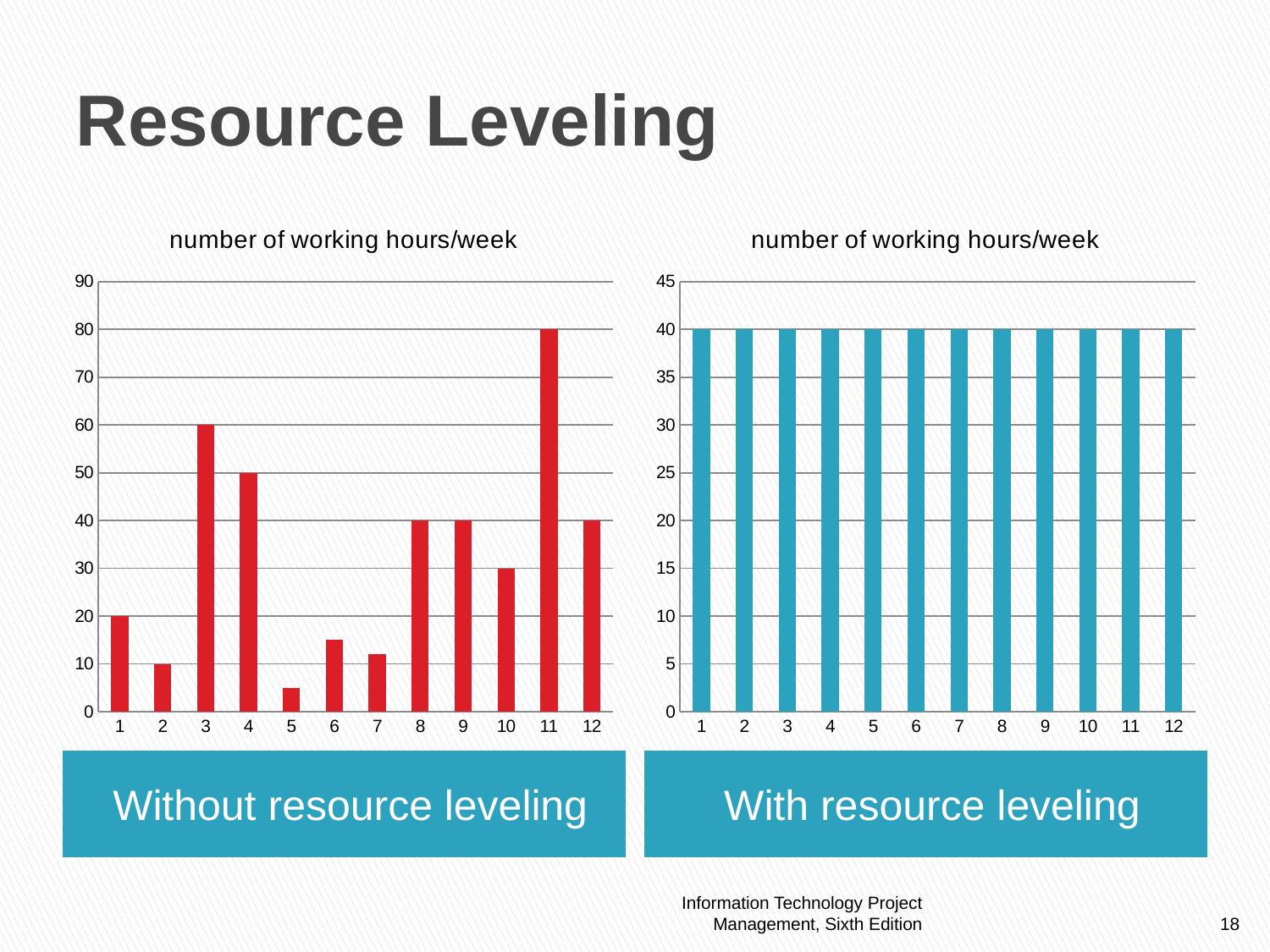
What type of chart is used in the right chart (With resource leveling)? Bar chart In the left chart (Without resource leveling), which week has more working hours, week 4 or week 10? Week 4 In the left chart (Without resource leveling), which week has the lowest number of working hours? 5 In the left chart (Without resource leveling), what is the number of working hours in week 11? 80 In the right chart (With resource leveling), do the values rise, fall, or stay constant across the weeks? Stay constant In the right chart (With resource leveling), what is the number of working hours in week 1? 40 How many weeks are shown on the x axis of the left chart (Without resource leveling)? 12 What is the title shown above each of the two charts? number of working hours/week In the left chart (Without resource leveling), what is the difference between the working hours in week 11 and week 3? 20 In the left chart (Without resource leveling), which week has the highest number of working hours? 11 In the left chart (Without resource leveling), is the value for week 6 greater or less than 20? less In the left chart (Without resource leveling), what is the number of working hours in week 3? 60